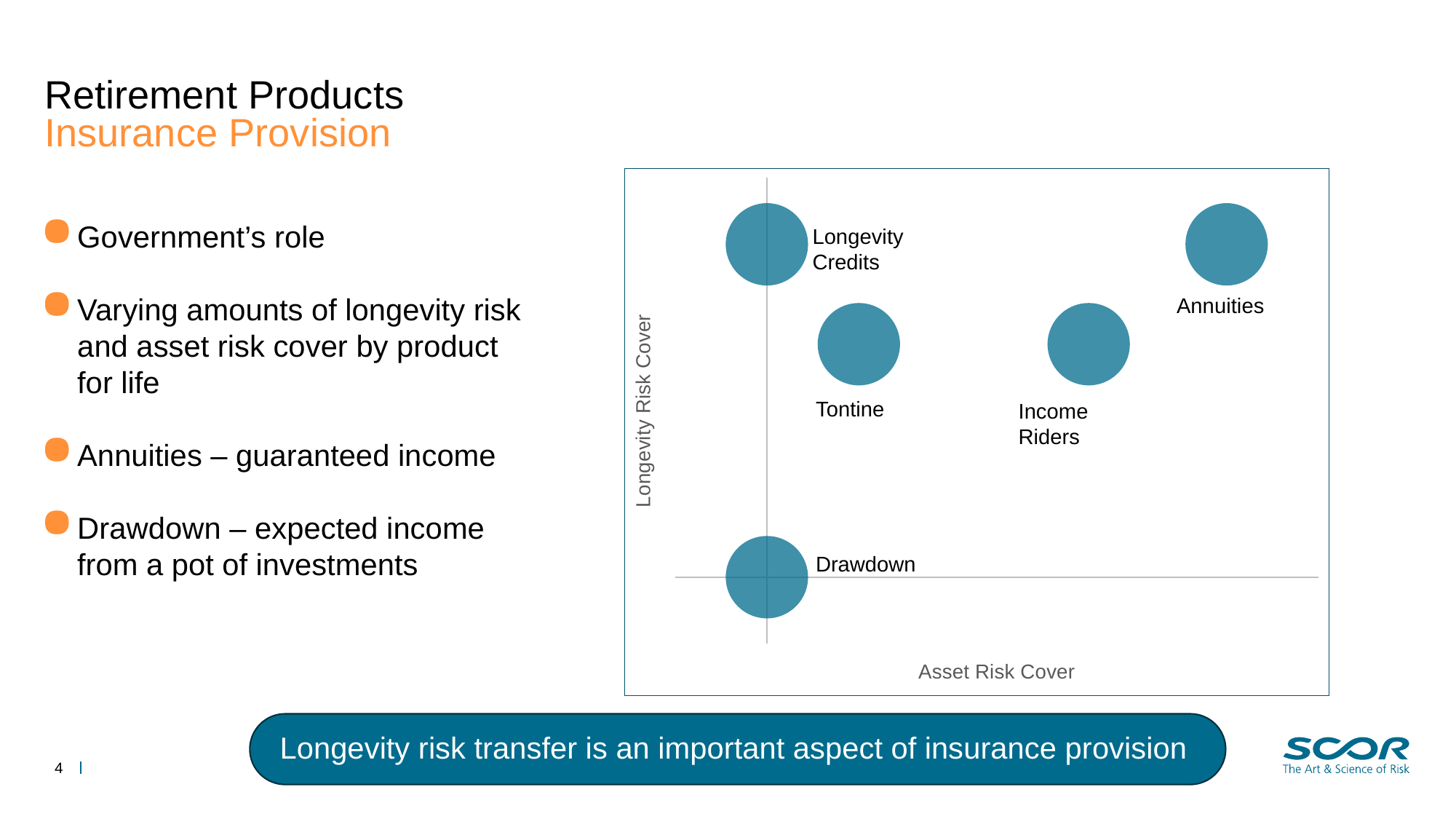
How many products are plotted on the chart? 5 Which product has the greater Asset Risk Cover, Longevity Credits or Annuities? Annuities Which product has the greater Longevity Risk Cover, Drawdown or Income Riders? Income Riders What kind of chart is shown on the slide? Bubble chart What is the label of the horizontal axis of the chart? Asset Risk Cover Which product is plotted with the lowest Longevity Risk Cover? Drawdown Which product has the greater Longevity Risk Cover, Tontine or Drawdown? Tontine What is the label of the vertical axis of the chart? Longevity Risk Cover Which product is plotted with the highest Asset Risk Cover? Annuities